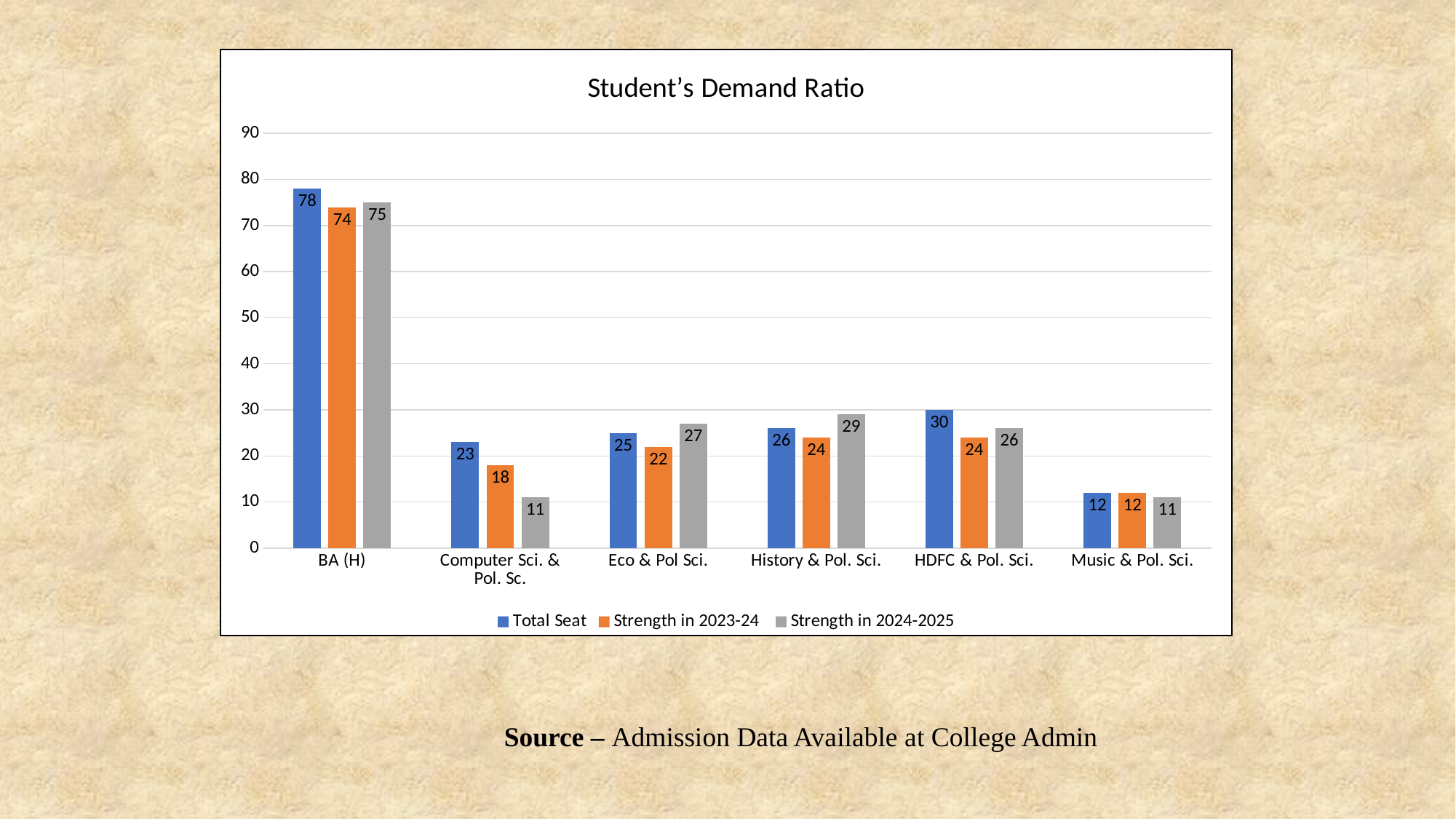
What is the Strength in 2024-2025 value for Computer Sci. & Pol. Sc.? 11 Which is larger for History & Pol. Sci.: Strength in 2023-24 or Strength in 2024-2025? Strength in 2024-2025 What is the difference between Total Seat and Strength in 2024-2025 for Computer Sci. & Pol. Sc.? 12 What is the Strength in 2023-24 value for Eco & Pol Sci.? 22 Which category has the highest Total Seat value? BA (H) How many series does the legend list? 3 What kind of chart is shown on the slide? Bar chart What is the Total Seat value for BA (H)? 78 What is the title of the chart? Student's Demand Ratio How many categories are shown on the x axis? 6 Which category has the lowest Strength in 2023-24 value? Music & Pol. Sci. Is the Total Seat value for HDFC & Pol. Sci. greater or less than 20? greater